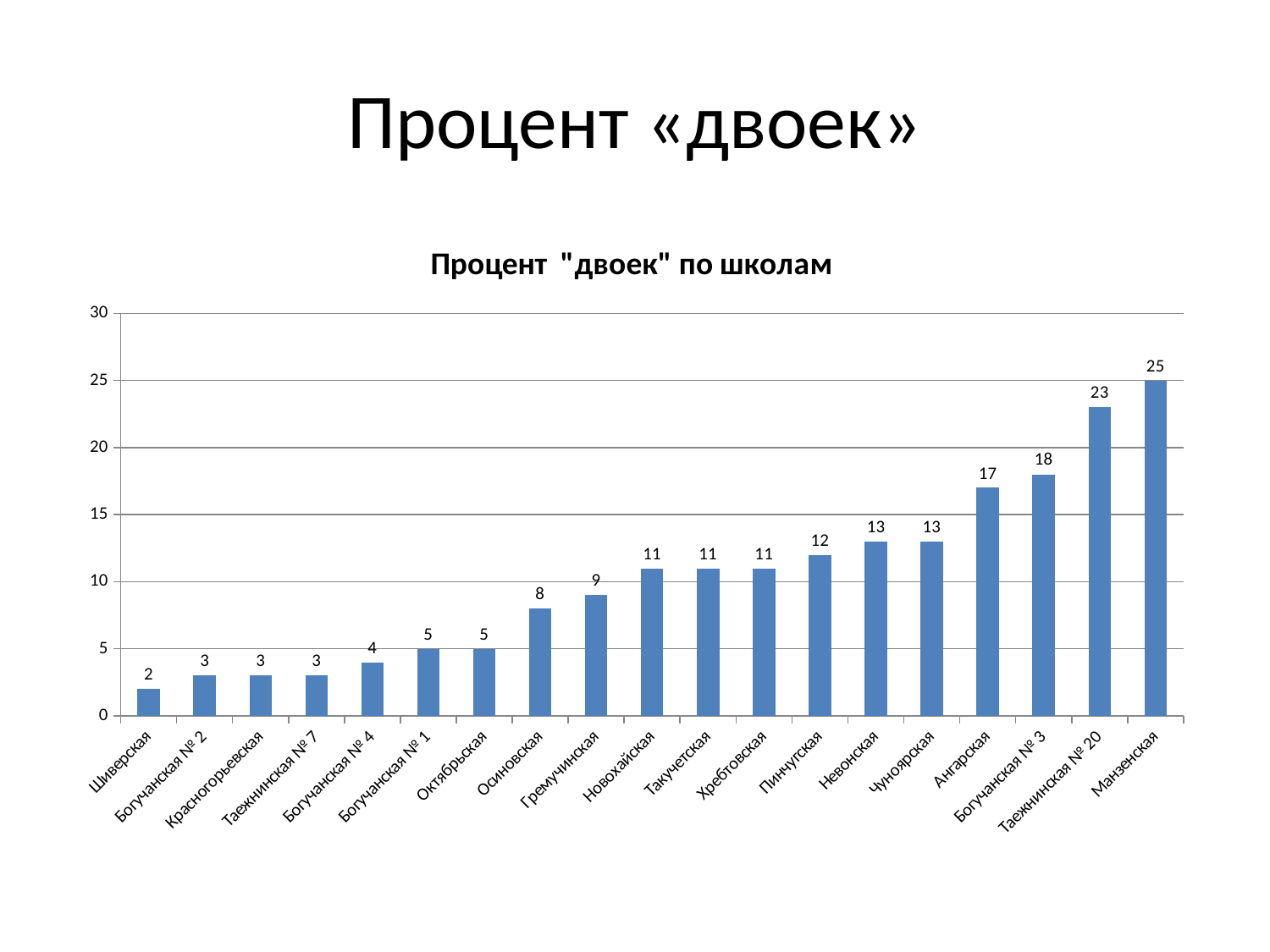
Which school has the highest value? Манзенская Which is larger, the value for Гремучинская or the value for Невонская? Невонская What is the value for Пинчугская? 12 How many schools are shown on the x axis? 19 What is the title of the chart? Процент "двоек" по школам What is the value for Манзенская? 25 Which school has the lowest value? Шиверская What is the difference between the values for Таежнинская № 20 and Богучанская № 3? 5 What kind of chart is this? bar chart What is the value for Осиновская? 8 Is the value for Богучанская № 3 greater or less than 15? greater What is the value for Ангарская? 17